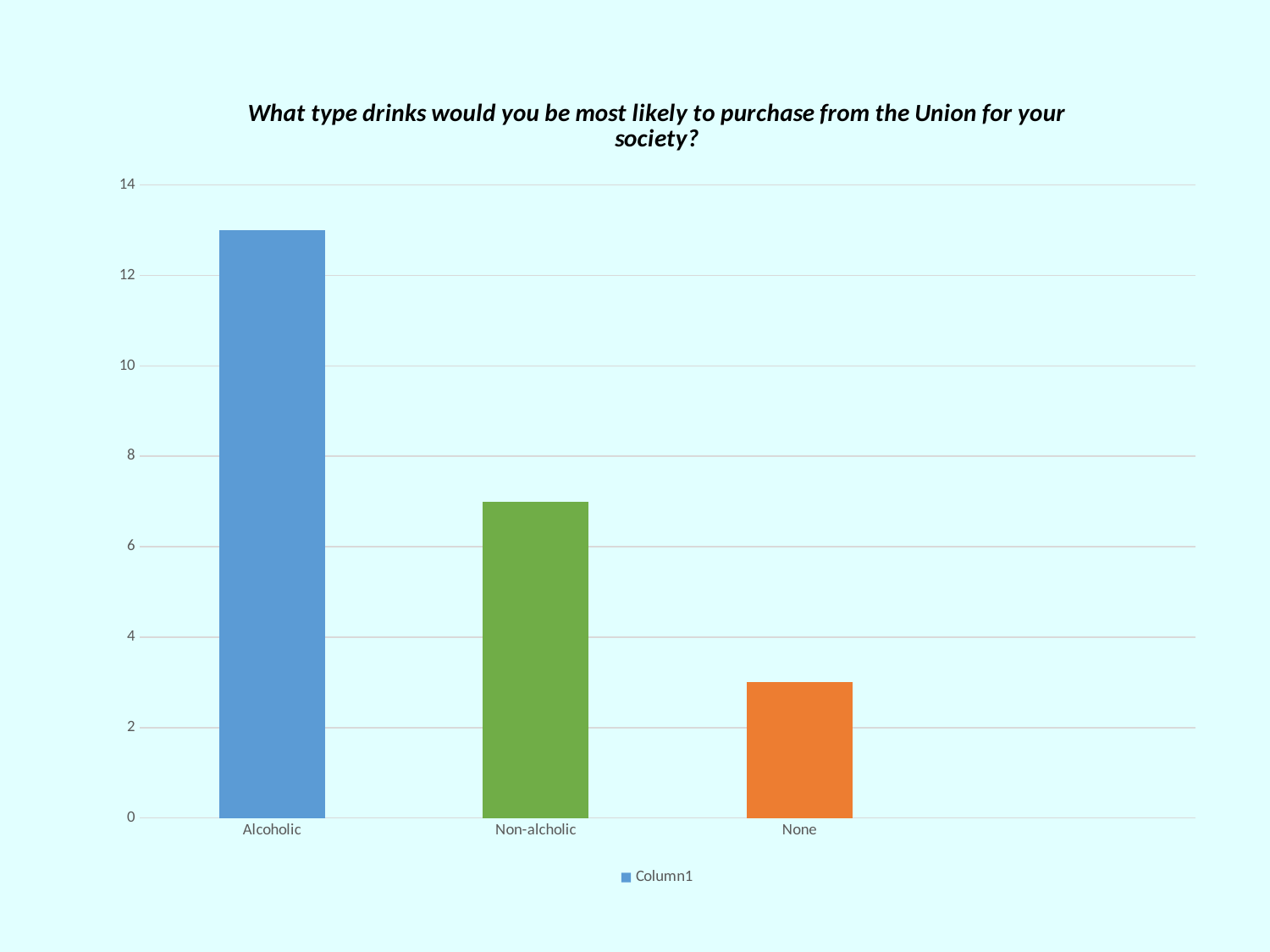
How many series does the legend list? 1 Is the value for Alcoholic greater or less than 12? greater Which is larger, the value for Alcoholic or the value for Non-alcholic? Alcoholic Which category has the lowest value? None Is the value for Non-alcholic greater or less than 8? less Is the value for None greater or less than 4? less Which category has the highest value? Alcoholic What kind of chart is shown on the slide? bar chart How many categories are shown on the x axis? 3 Which is larger, the value for Non-alcholic or the value for None? Non-alcholic Do the values rise or fall from left to right along the x axis? fall